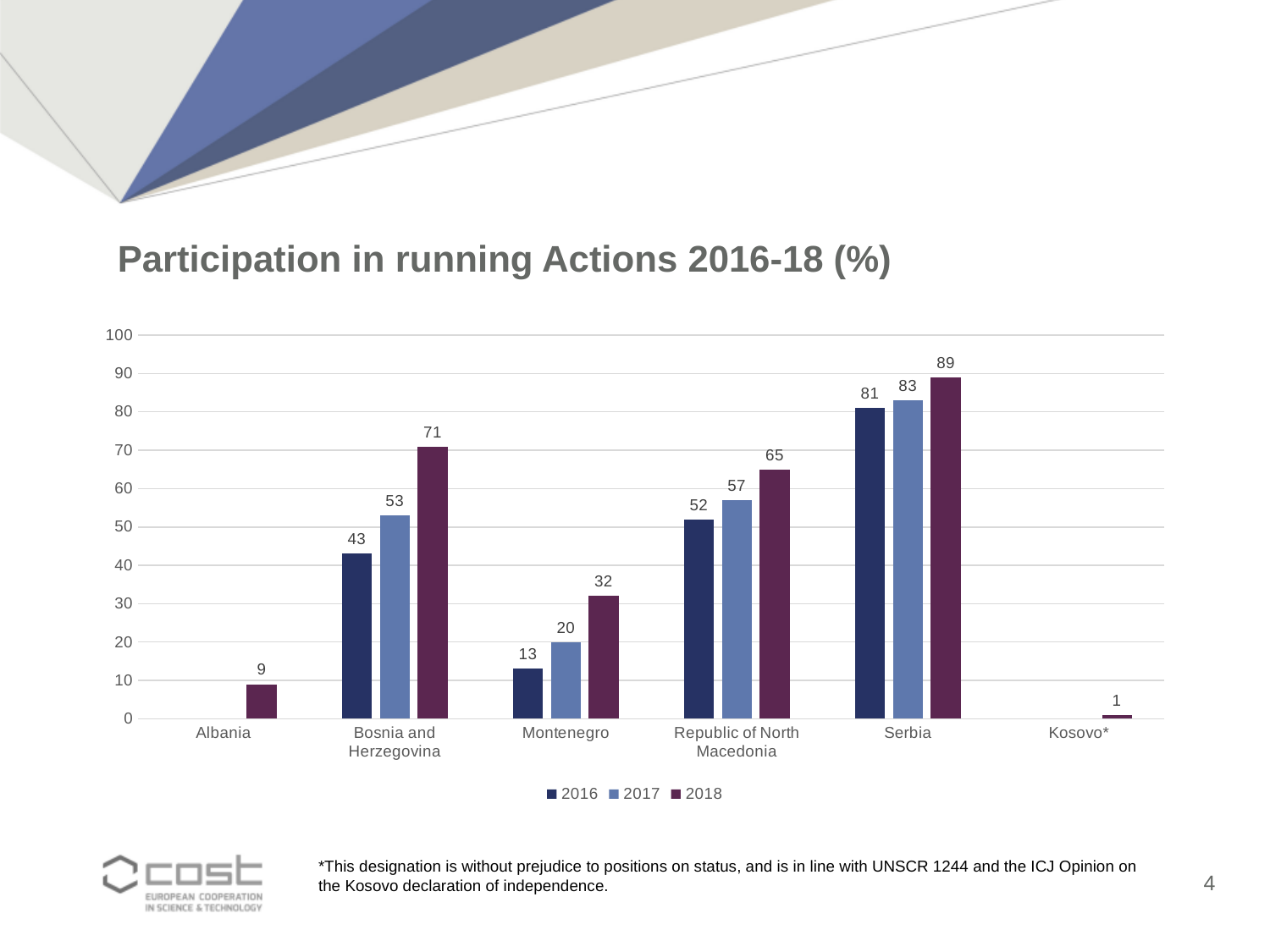
How many series does the legend list? 3 Which is larger, the 2017 value for Montenegro or the 2017 value for Bosnia and Herzegovina? Bosnia and Herzegovina What is the 2017 value for Republic of North Macedonia? 57 What kind of chart is shown on the slide? bar chart What is the title of the chart? Participation in running Actions 2016-18 (%) What is the difference between the 2018 and 2016 values for Serbia? 8 What is the 2016 value for Montenegro? 13 Which category has the highest 2018 value? Serbia Which category has the lowest 2018 value? Kosovo* How many categories are shown on the x axis? 6 What is the 2018 value for Bosnia and Herzegovina? 71 Do the values for Republic of North Macedonia rise or fall from 2016 to 2018? rise